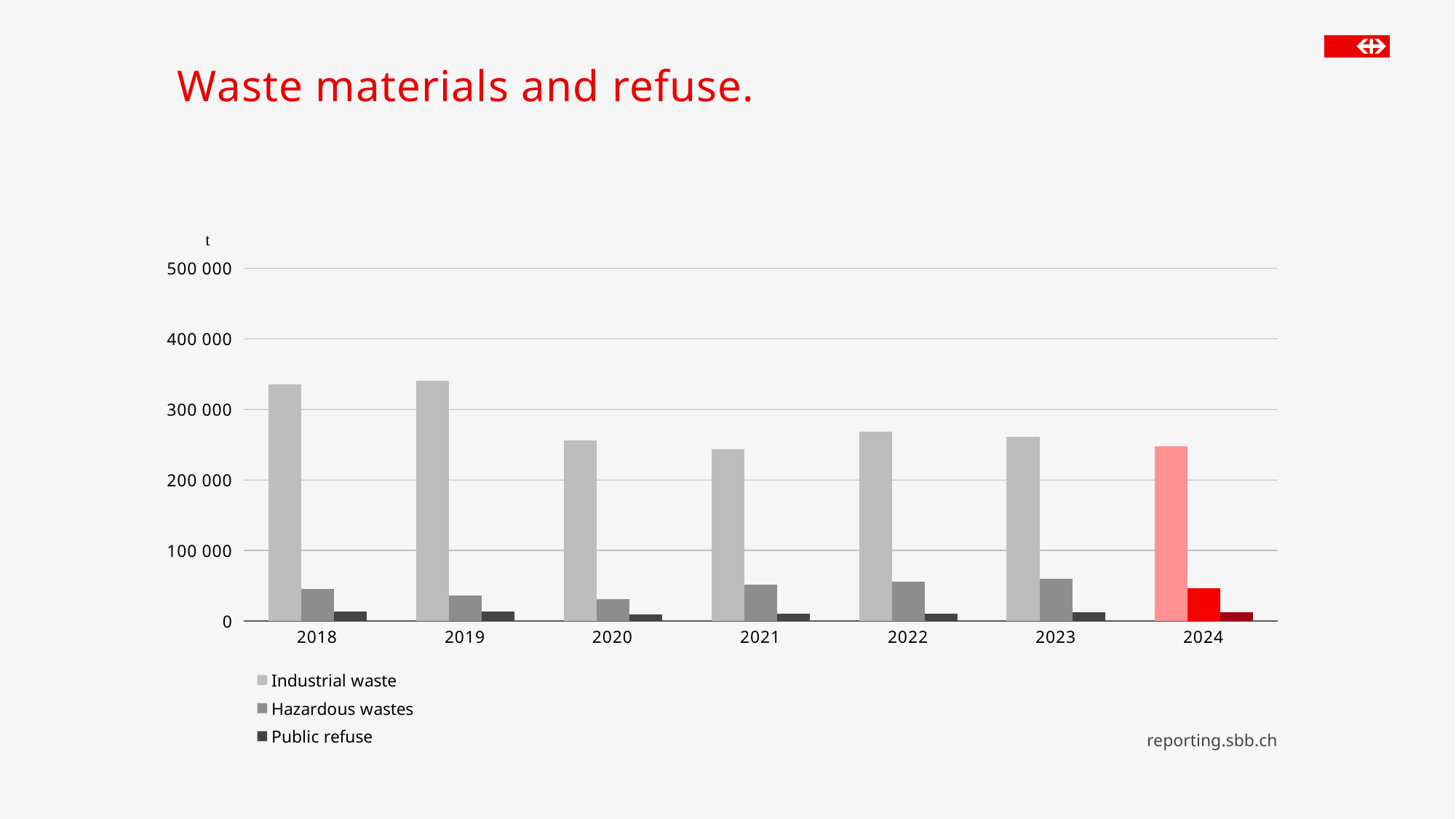
Is the value for Hazardous wastes in 2023 greater or less than 100 000? less What unit is shown on the y axis? t Which year has the lowest value for Hazardous wastes? 2020 Which is larger, Industrial waste in 2018 or Industrial waste in 2020? 2018 What kind of chart is shown on the slide? bar chart How many series does the legend list? 3 Is the value for Industrial waste in 2018 greater or less than 300 000? greater How many years are shown on the x axis? 7 Is the value for Industrial waste in 2024 greater or less than 200 000? greater Which series has the smallest values in every year? Public refuse Which year has the highest value for Hazardous wastes? 2023